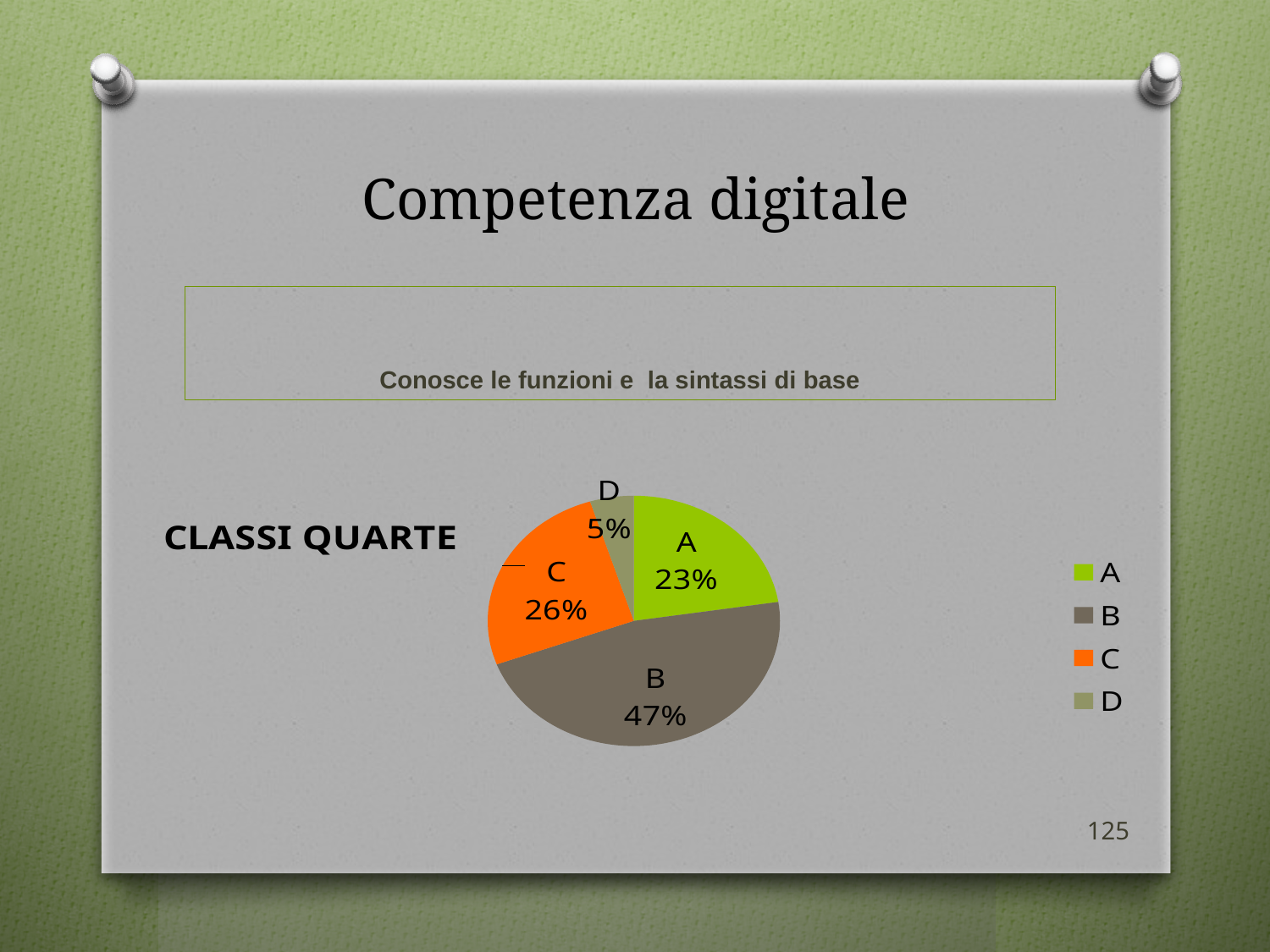
Which category has the largest slice of the pie? B What is the difference in percentage points between category B and category A? 24 Which is larger, the share for category C or the share for category A? C What share of the pie does category A have? 23% What share of the pie does category B have? 47% What share of the pie does category C have? 26% What kind of chart is shown on the slide? pie chart How many slices does the pie chart have? 4 How many entries does the legend list? 4 What colour is the slice for category C? orange Which category has the smallest slice of the pie? D